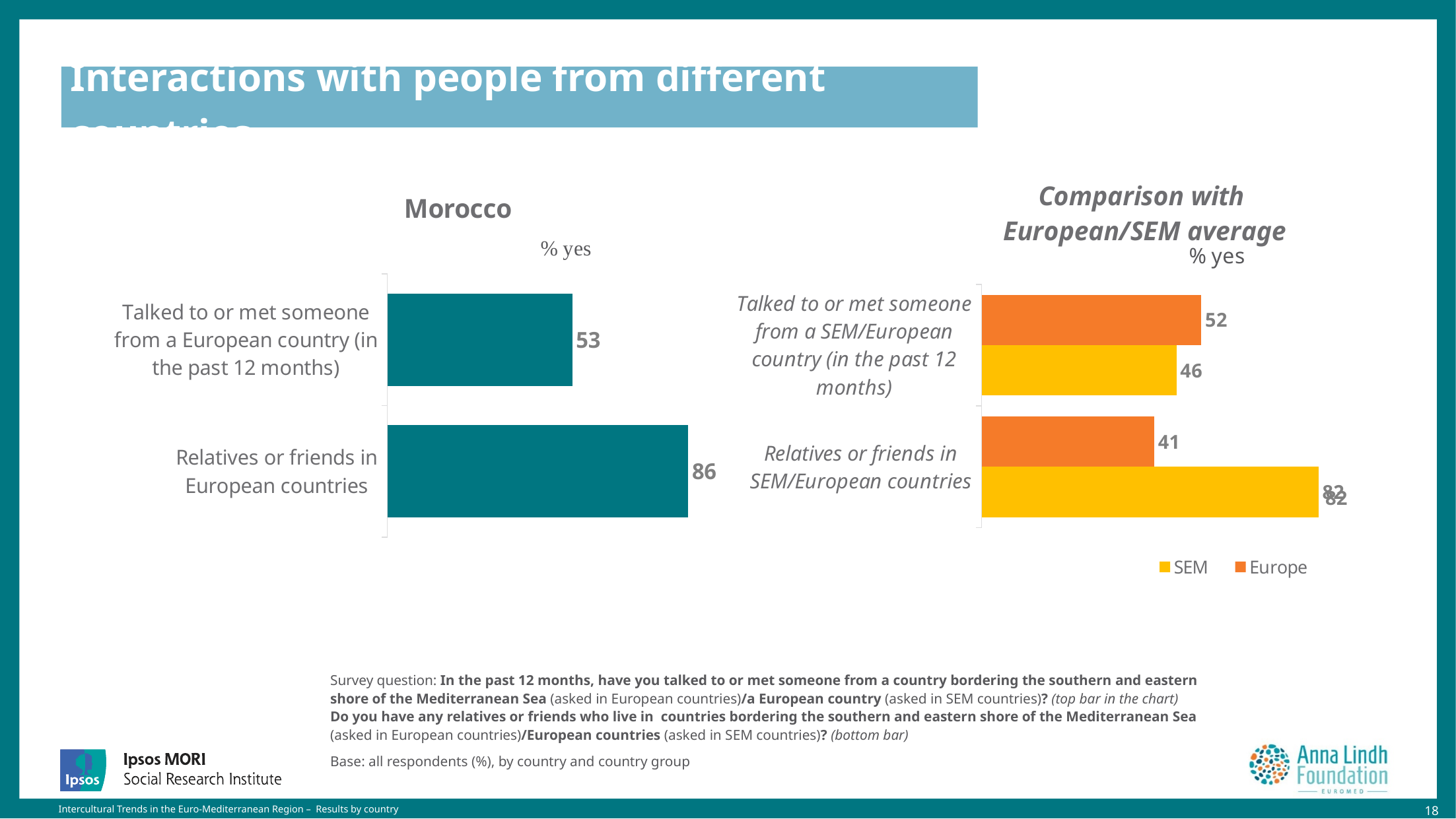
In the Comparison with European/SEM average chart, what is the Europe value for relatives or friends in SEM/European countries? 41 In the Morocco chart, which category has the higher value? Relatives or friends in European countries In the Morocco chart, what percentage said they have relatives or friends in European countries? 86 In the Comparison with European/SEM average chart, what is the SEM value for talked to or met someone from a SEM/European country? 46 In the Morocco chart, what percentage said they talked to or met someone from a European country in the past 12 months? 53 In the Comparison with European/SEM average chart, how many series does the legend list? 2 In the Morocco chart, how many categories are plotted? 2 What type of chart is the Morocco chart? Bar chart In the Comparison with European/SEM average chart, what colour represents the SEM series? Yellow In the Comparison with European/SEM average chart, which series has the larger value for talked to or met someone from a SEM/European country, SEM or Europe? Europe In the Morocco chart, what is the difference between the value for relatives or friends in European countries and the value for talked to or met someone from a European country? 33 In the Comparison with European/SEM average chart, what is the Europe value for talked to or met someone from a SEM/European country? 52